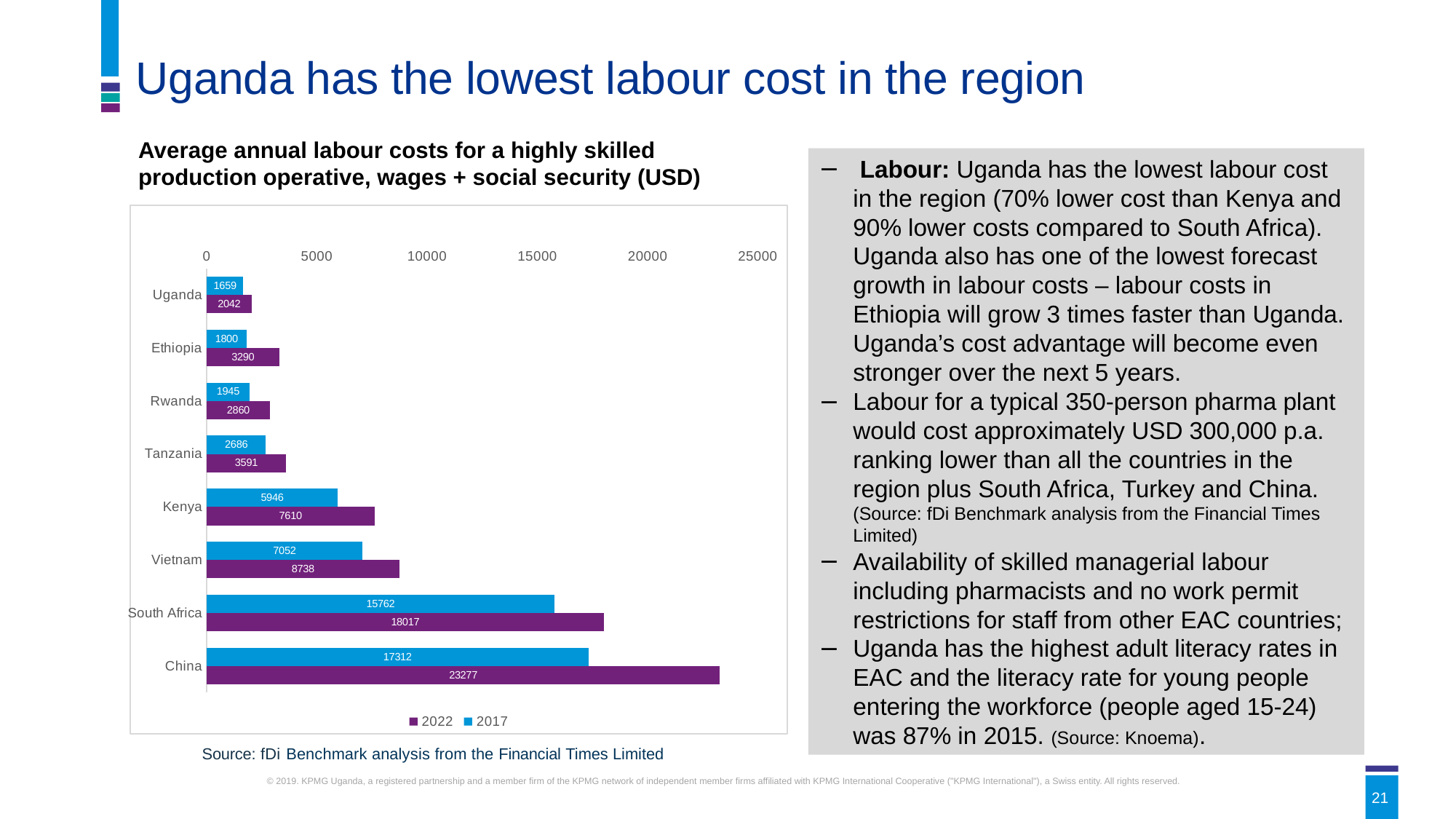
How many series does the legend list? 2 What is the 2017 value for Uganda? 1659 What is the 2022 value for China? 23277 What is the difference between the 2022 and 2017 values for South Africa? 2255 Which is larger, the 2017 value for Kenya or the 2017 value for Vietnam? Vietnam How many countries are shown on the chart? 8 Which country has the lowest 2017 value? Uganda Is the 2022 value for China greater or less than 20000? greater What type of chart is shown? Bar chart Which colour represents the 2022 series? Purple What is the 2022 value for Ethiopia? 3290 Which country has the highest 2022 value? China